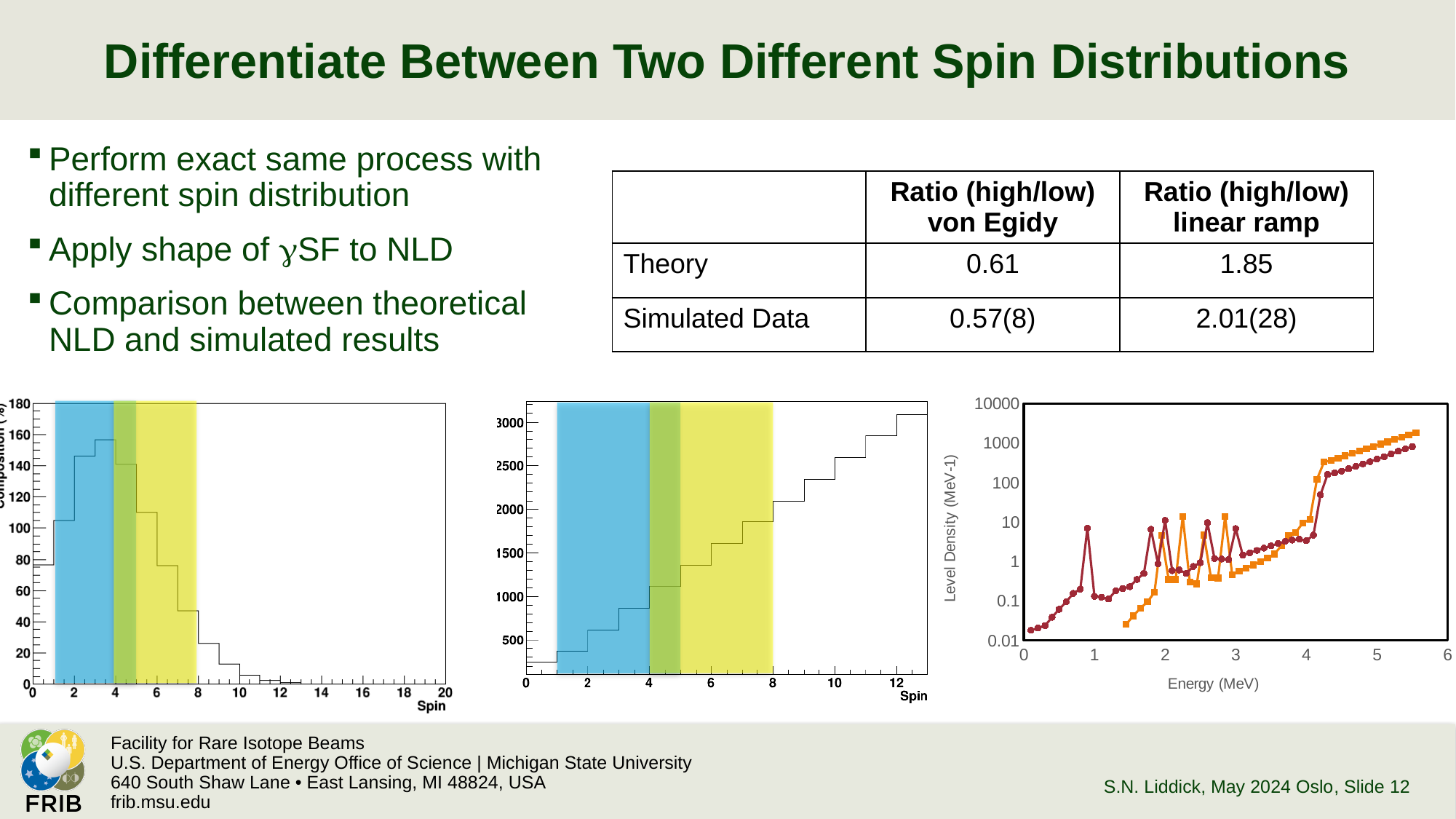
What kind of chart is the rightmost chart (Level Density vs Energy)? line chart In the middle chart, is the histogram value at spin 11 greater or less than 2500? greater In the leftmost chart, is the peak value of the histogram (around spin 3 to 4) greater or less than 140? greater What is the y-axis label of the rightmost chart? Level Density (MeV-1) How many data series are plotted in the rightmost chart? 2 In the leftmost chart, is the histogram value at spin 9 greater or less than 40? less What is the x-axis label of the leftmost chart? Spin In the middle chart, do the histogram values rise or fall as spin increases from 0 to 12? rise What is the x-axis label of the rightmost chart? Energy (MeV) In the rightmost chart, at an energy of about 5.5 MeV, which series has the higher level density, the orange squares or the red circles? orange squares